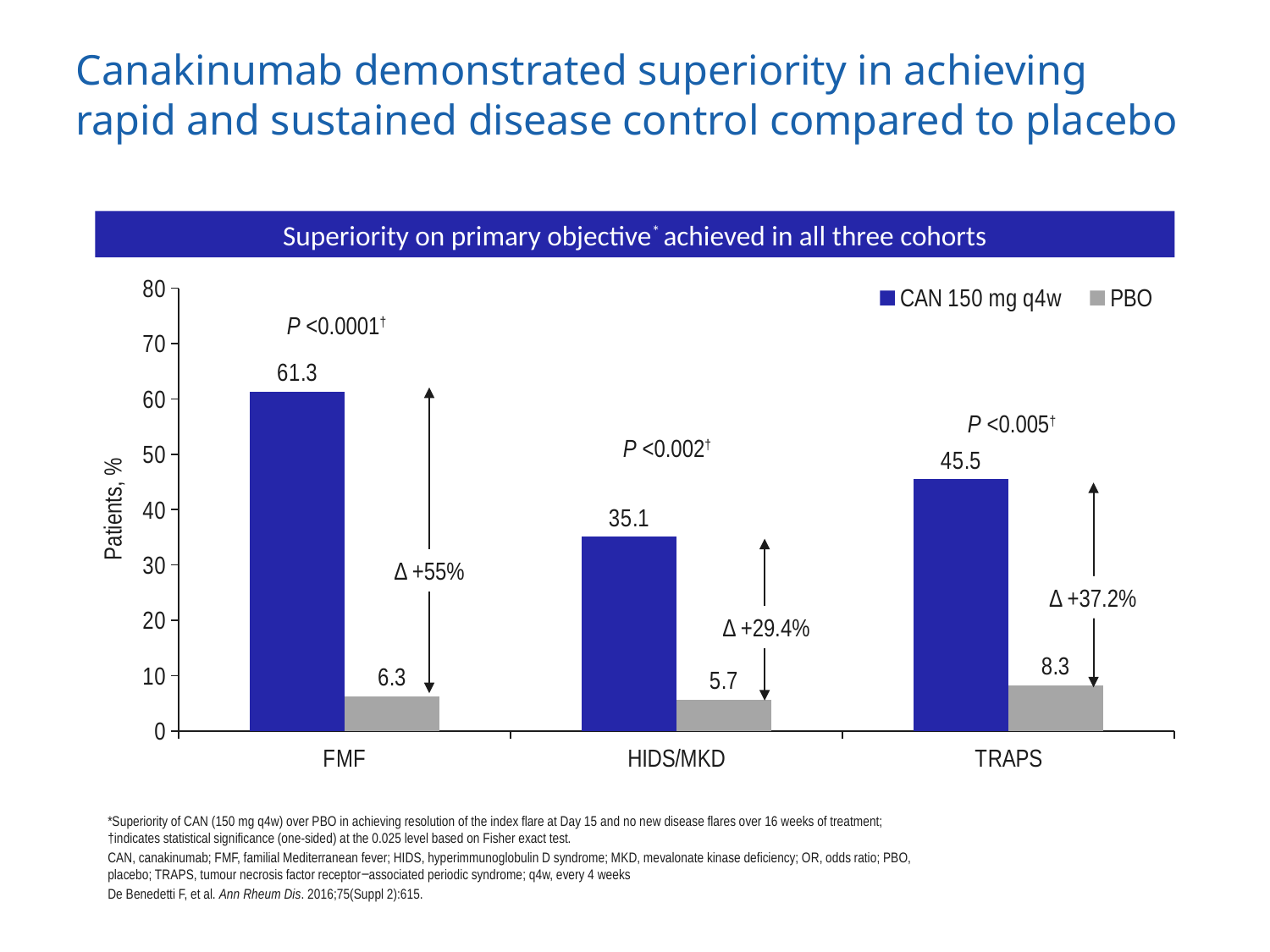
What is the difference between the CAN 150 mg q4w and PBO values in the TRAPS cohort? 37.2 Is the value for CAN 150 mg q4w in the HIDS/MKD cohort greater or less than 40? less Which cohort has the highest value for CAN 150 mg q4w? FMF Which cohort has the lowest value for PBO? HIDS/MKD How many series does the legend list? 2 What is the value for PBO in the HIDS/MKD cohort? 5.7 What kind of chart is shown on the slide? bar chart What is the value for CAN 150 mg q4w in the TRAPS cohort? 45.5 How many cohorts are shown on the x axis? 3 What is the label of the y axis? Patients, % Which is larger, the PBO value for FMF or the PBO value for TRAPS? TRAPS What is the value for CAN 150 mg q4w in the FMF cohort? 61.3